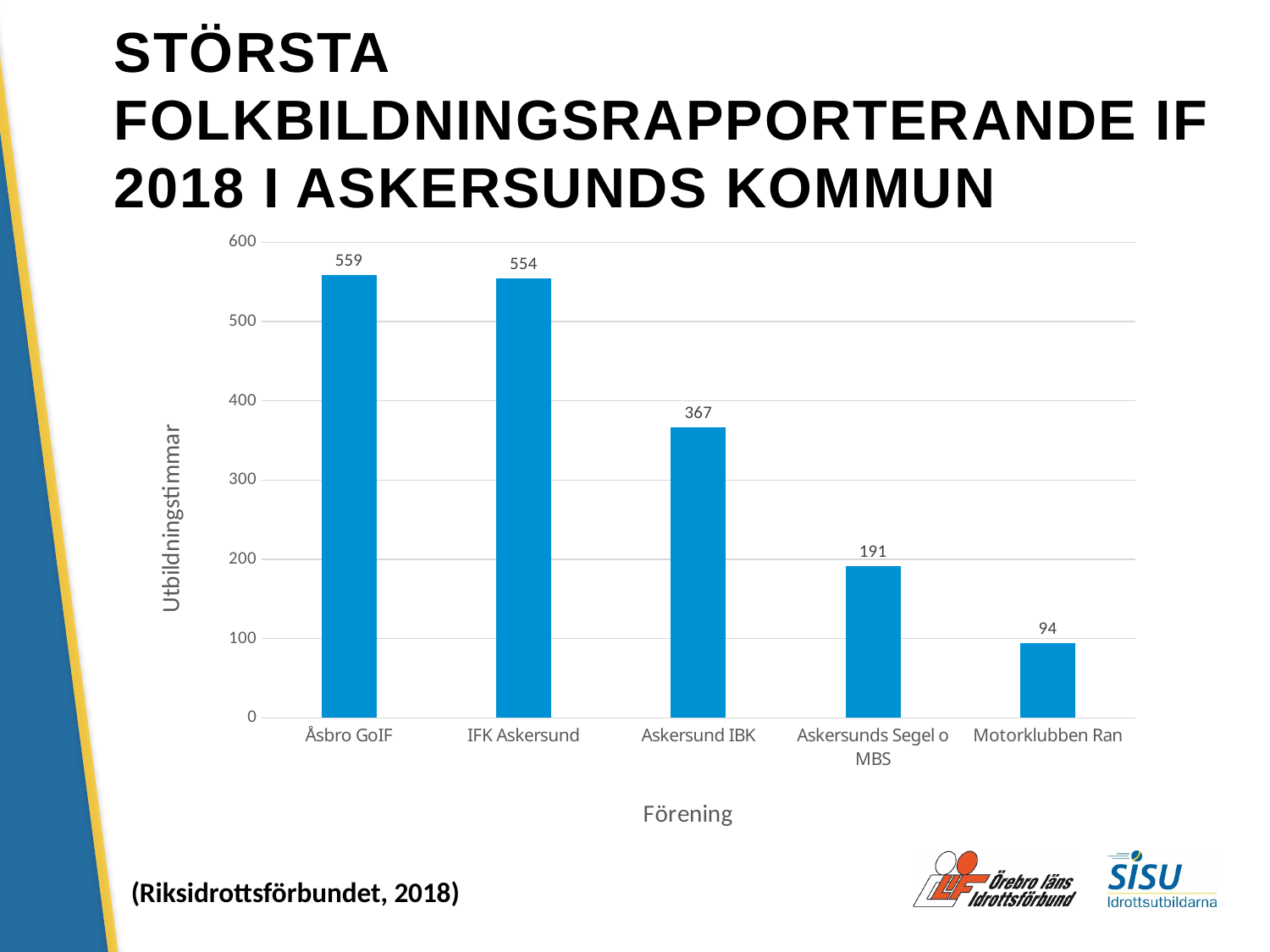
What is the value for Motorklubben Ran? 94 What is the difference between the values for Åsbro GoIF and IFK Askersund? 5 What is the value for Askersund IBK? 367 What is the difference between the values for Askersund IBK and Askersunds Segel o MBS? 176 What is the label of the vertical axis? Utbildningstimmar How many föreningar are shown in the chart? 5 Which is larger, the value for Askersund IBK or the value for Askersunds Segel o MBS? Askersund IBK How many utbildningstimmar are shown for Åsbro GoIF? 559 Which förening has the lowest number of utbildningstimmar? Motorklubben Ran What kind of chart is shown on the slide? bar chart Is the value for Askersunds Segel o MBS greater or less than 200? less Which förening has the highest number of utbildningstimmar? Åsbro GoIF